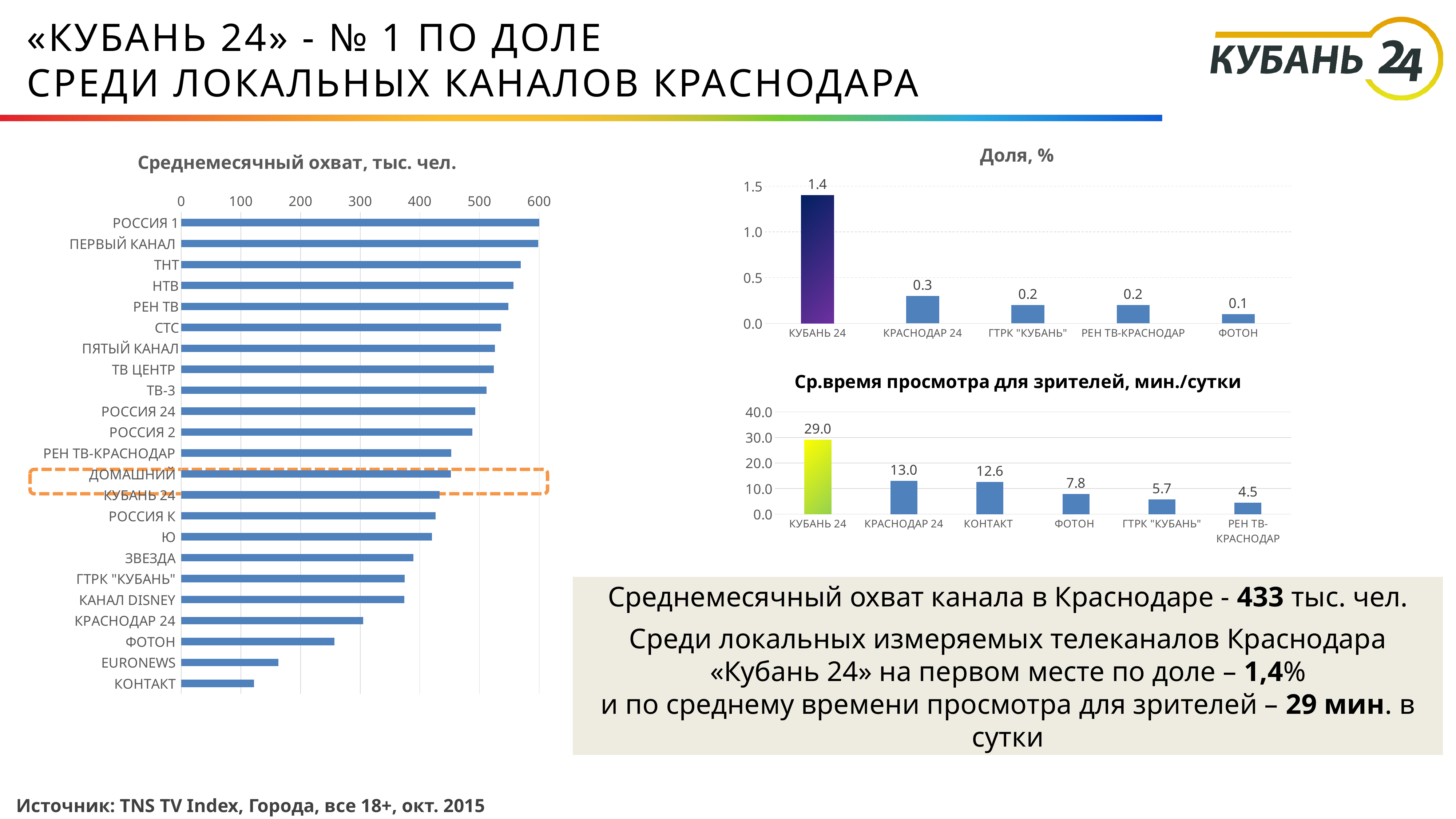
In the chart titled «Среднемесячный охват, тыс. чел.», is the value for ФОТОН greater or less than 300? less In the chart titled «Среднемесячный охват, тыс. чел.», which channel has the lowest value? КОНТАКТ In the chart titled «Доля, %», which channel has the lowest value? ФОТОН In the chart titled «Доля, %», what is the difference between КУБАНЬ 24 and КРАСНОДАР 24? 1.1 In the chart titled «Среднемесячный охват, тыс. чел.», how many channels are listed? 23 In the chart titled «Ср.время просмотра для зрителей, мин./сутки», do the values rise or fall from left to right? fall In the chart titled «Ср.время просмотра для зрителей, мин./сутки», what is the value for ФОТОН? 7.8 In the chart titled «Ср.время просмотра для зрителей, мин./сутки», what is the difference between КУБАНЬ 24 and КРАСНОДАР 24? 16.0 In the chart titled «Доля, %», how many channels are shown? 5 In the chart titled «Доля, %», what is the value for КУБАНЬ 24? 1.4 In the chart titled «Ср.время просмотра для зрителей, мин./сутки», which is larger: КРАСНОДАР 24 or КОНТАКТ? КРАСНОДАР 24 What kind of chart is the chart titled «Среднемесячный охват, тыс. чел.»? bar chart